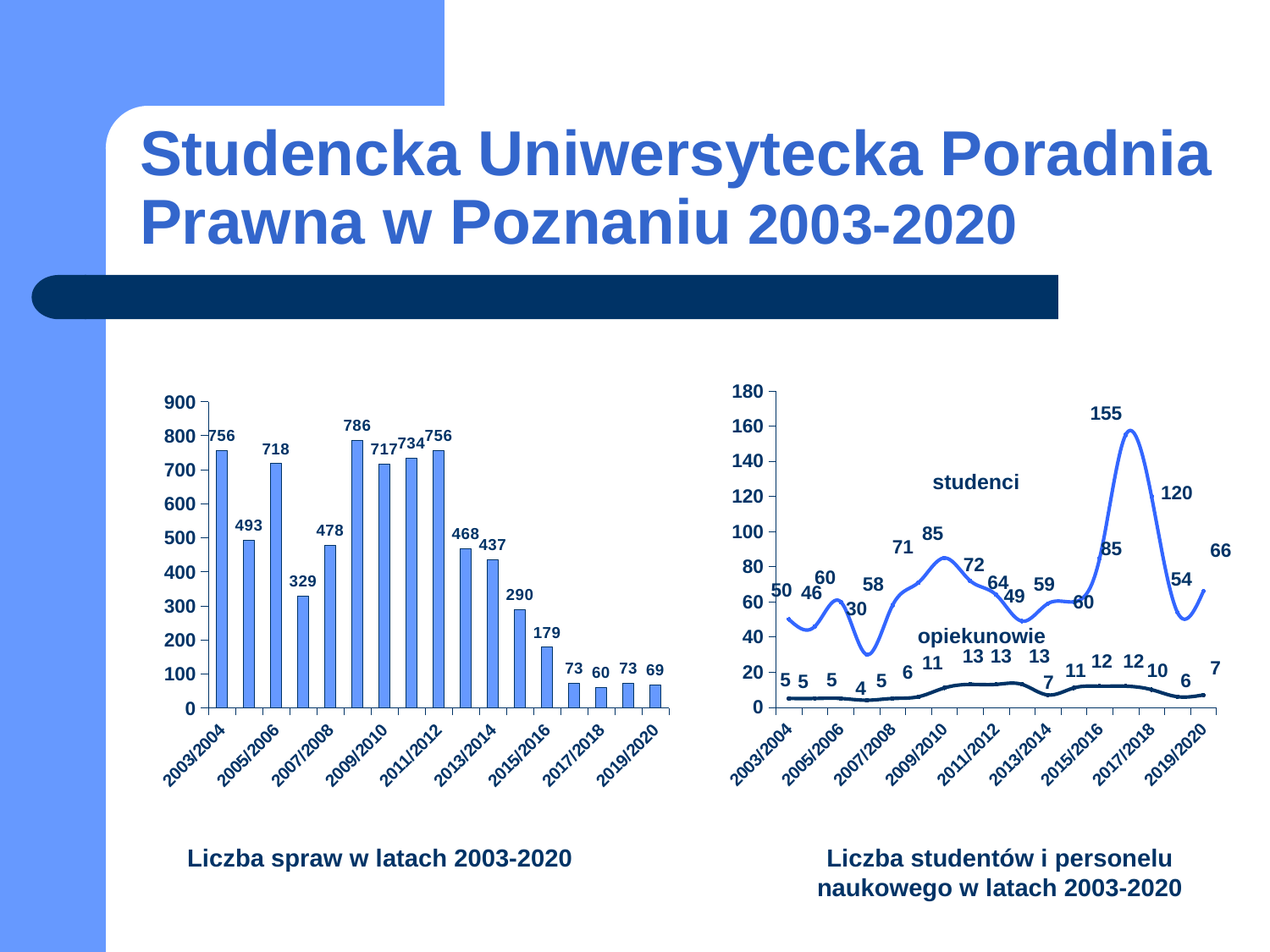
In the right chart 'Liczba studentów i personelu naukowego w latach 2003-2020', which series has the larger value in 2013/2014, studenci or opiekunowie? studenci In the right chart 'Liczba studentów i personelu naukowego w latach 2003-2020', how many series are plotted? 2 What kind of chart is the left chart, 'Liczba spraw w latach 2003-2020'? bar chart In the left chart 'Liczba spraw w latach 2003-2020', how many bars are there? 17 In the right chart 'Liczba studentów i personelu naukowego w latach 2003-2020', what is the lowest value for opiekunowie? 4 In the left chart 'Liczba spraw w latach 2003-2020', what is the value for 2015/2016? 179 In the left chart 'Liczba spraw w latach 2003-2020', what is the lowest value shown? 60 In the right chart 'Liczba studentów i personelu naukowego w latach 2003-2020', what is the value for studenci in 2019/2020? 66 In the right chart 'Liczba studentów i personelu naukowego w latach 2003-2020', what is the highest value for studenci? 155 In the left chart 'Liczba spraw w latach 2003-2020', what is the value for 2003/2004? 756 In the left chart 'Liczba spraw w latach 2003-2020', what is the highest value shown? 786 In the left chart 'Liczba spraw w latach 2003-2020', what is the difference between the values for 2005/2006 and 2007/2008? 240